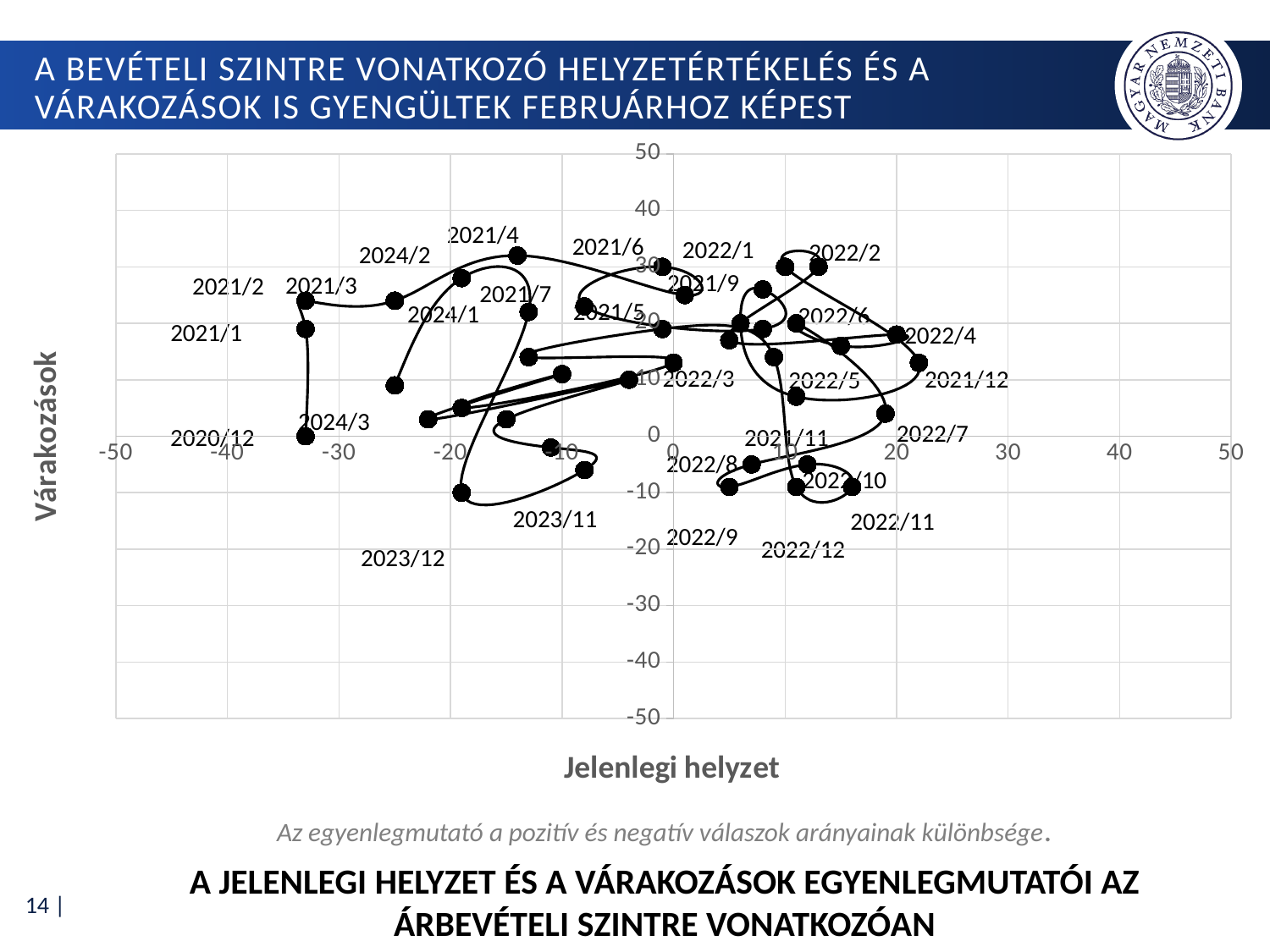
What is the label of the horizontal axis of the chart? Jelenlegi helyzet What is the minimum value shown on the horizontal axis? -50 What is the maximum value shown on the vertical axis? 50 Is the Várakozások value for 2022/10 greater or less than 0? less Is the Jelenlegi helyzet value for 2022/4 greater or less than 10? greater Is the Jelenlegi helyzet value for 2022/2 greater or less than 0? greater What is the label of the vertical axis of the chart? Várakozások What kind of chart is shown on the slide? scatter chart